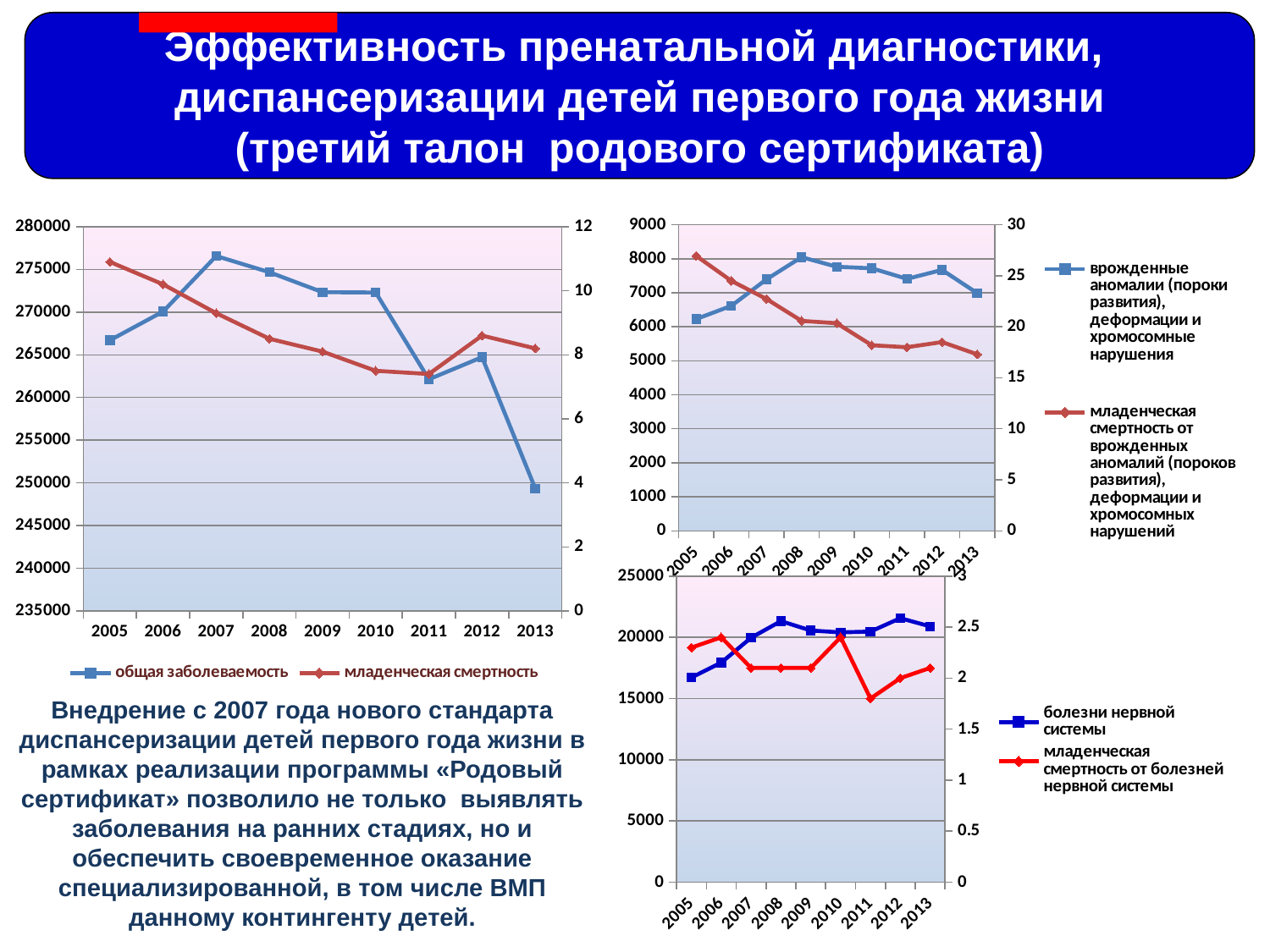
In the chart on the left of the slide, is the value of общая заболеваемость for 2013 greater or less than 255000? less In the chart on the left of the slide, is the value of младенческая смертность for 2005 greater or less than 10? greater In the bottom-right chart, in which year is the series младенческая смертность от болезней нервной системы lowest? 2011 In the chart on the left of the slide, how many years are plotted along the x axis? 9 In the chart on the left of the slide, in which year is общая заболеваемость highest? 2007 In the top-right chart, does the series младенческая смертность от врожденных аномалий rise or fall from 2005 to 2013? fall In the bottom-right chart, is the value of болезни нервной системы for 2005 greater or less than 20000? less What kind of chart is the chart on the left of the slide? line chart In the top-right chart, in which year is the series младенческая смертность от врожденных аномалий lowest? 2013 In the chart on the left of the slide, in which year is общая заболеваемость lowest? 2013 In the top-right chart, in which year is the series врожденные аномалии highest? 2008 In the chart on the left of the slide, how many series does the legend list? 2